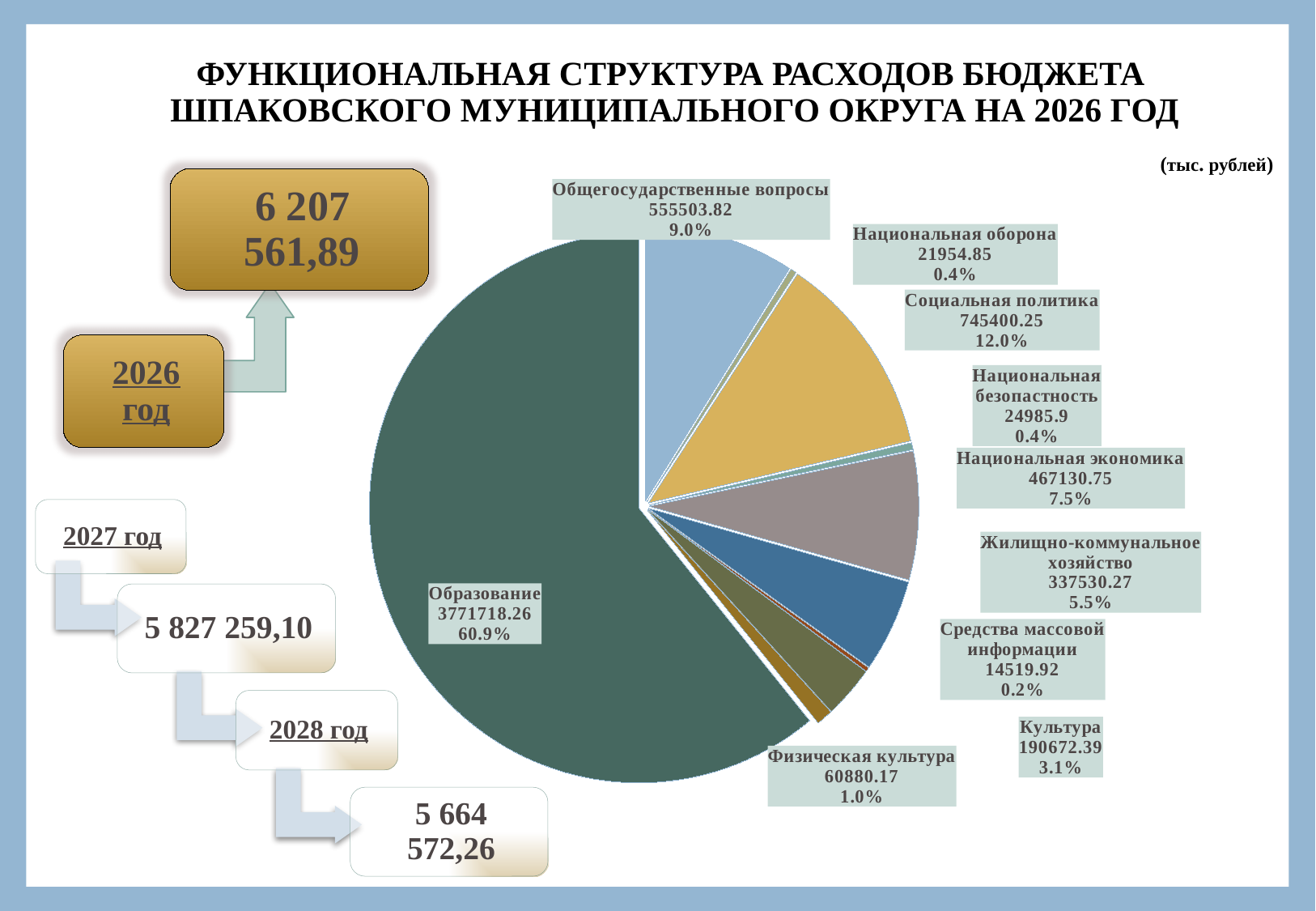
How many categories (slices) does the pie chart show? 10 What share of the pie does Национальная экономика represent? 7.5% Which category has the largest slice of the pie? Образование What kind of chart is shown on the slide? pie chart What is the difference between the values for Общегосударственные вопросы and Национальная экономика? 88373.07 What is the value for Образование in the pie chart? 3771718.26 What is the value for Социальная политика? 745400.25 Which category has the smallest slice of the pie? Средства массовой информации What share of the pie does Культура represent? 3.1% What is the value for Жилищно-коммунальное хозяйство? 337530.27 In what units are the values in the chart given, according to the slide? тыс. рублей Which is larger: Культура or Физическая культура? Культура